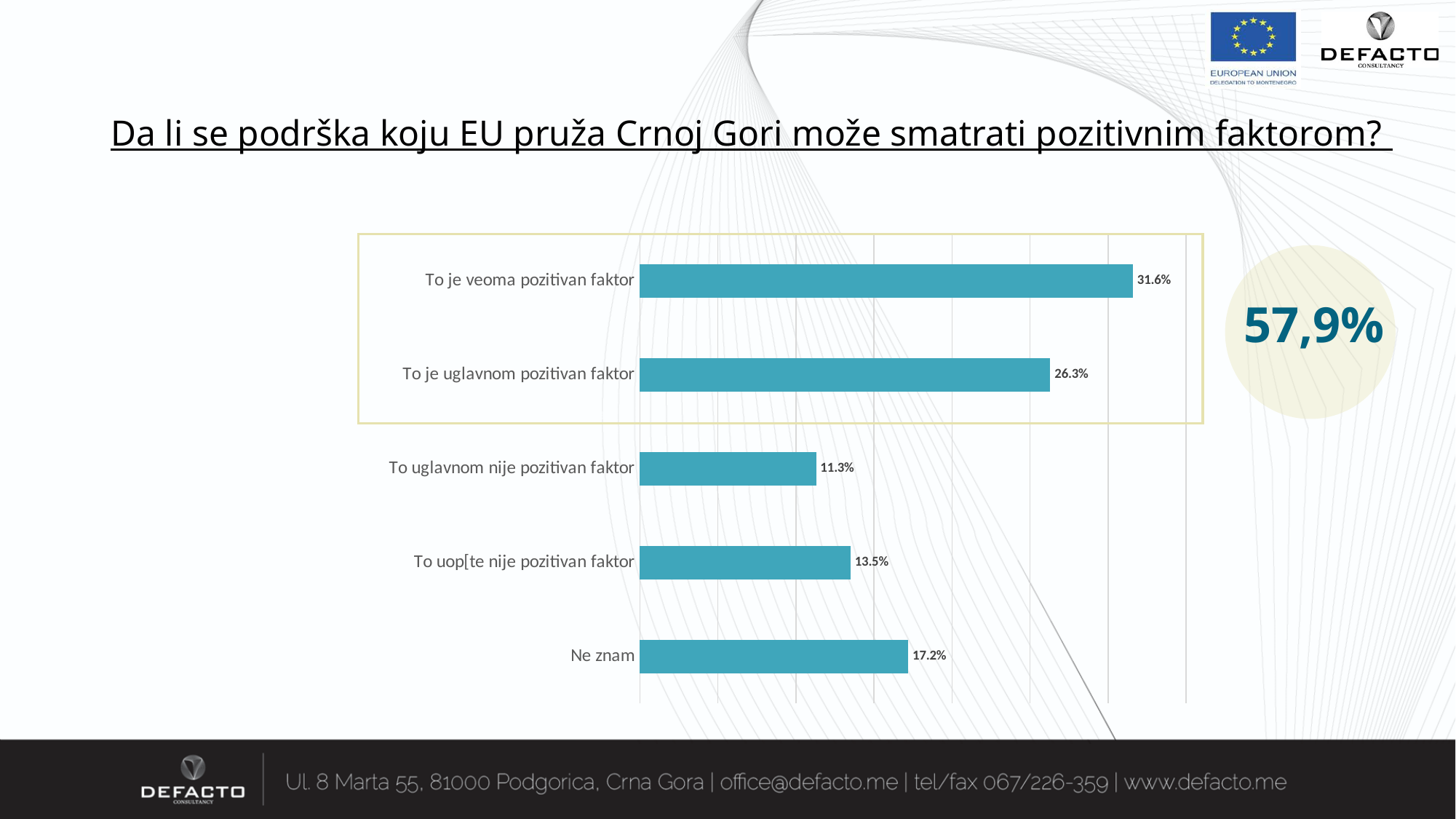
What is the value for "To je uglavnom pozitivan faktor"? 26.3% What is the difference between the values for "To je veoma pozitivan faktor" and "To je uglavnom pozitivan faktor"? 5.3% What is the value for "To je veoma pozitivan faktor"? 31.6% What is the total of the values for "To je veoma pozitivan faktor" and "To je uglavnom pozitivan faktor"? 57.9% Which category has the lowest value? To uglavnom nije pozitivan faktor Which is larger, the value for "Ne znam" or the value for "To uop[te nije pozitivan faktor"? Ne znam Which category has the highest value? To je veoma pozitivan faktor What is the value for "Ne znam"? 17.2% What is the value for "To uglavnom nije pozitivan faktor"? 11.3% What kind of chart is shown on the slide? Bar chart How many categories are shown in the chart? 5 What large percentage is shown in the circle to the right of the chart? 57,9%